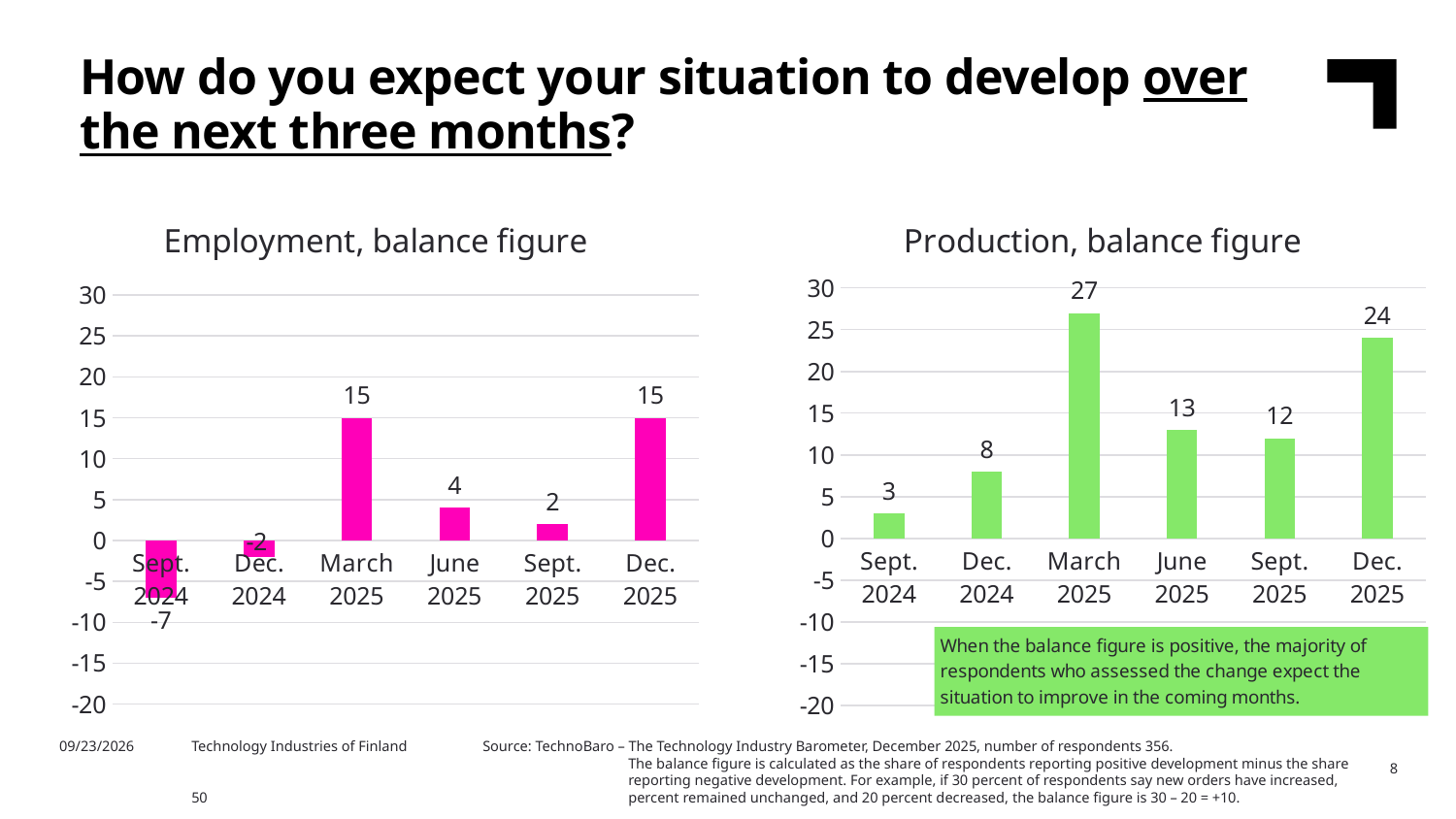
In the Production, balance figure chart, what is the value for Dec. 2024? 8 In the Production, balance figure chart, what is the difference between the values for Dec. 2025 and Sept. 2025? 12 What colour are the bars in the Employment, balance figure chart? Pink In the Production, balance figure chart, which period has the lowest value? Sept. 2024 In the Employment, balance figure chart, what is the difference between the values for March 2025 and Sept. 2025? 13 What kind of chart is the Production, balance figure chart? Bar chart In the Employment, balance figure chart, what is the value for June 2025? 4 In the Employment, balance figure chart, what is the value for Sept. 2024? -7 In the Production, balance figure chart, which period has the highest value? March 2025 In the Employment, balance figure chart, how many periods are shown? 6 In the Production, balance figure chart, which is larger, the value for June 2025 or the value for Sept. 2025? June 2025 In the Employment, balance figure chart, which period has the lowest value? Sept. 2024